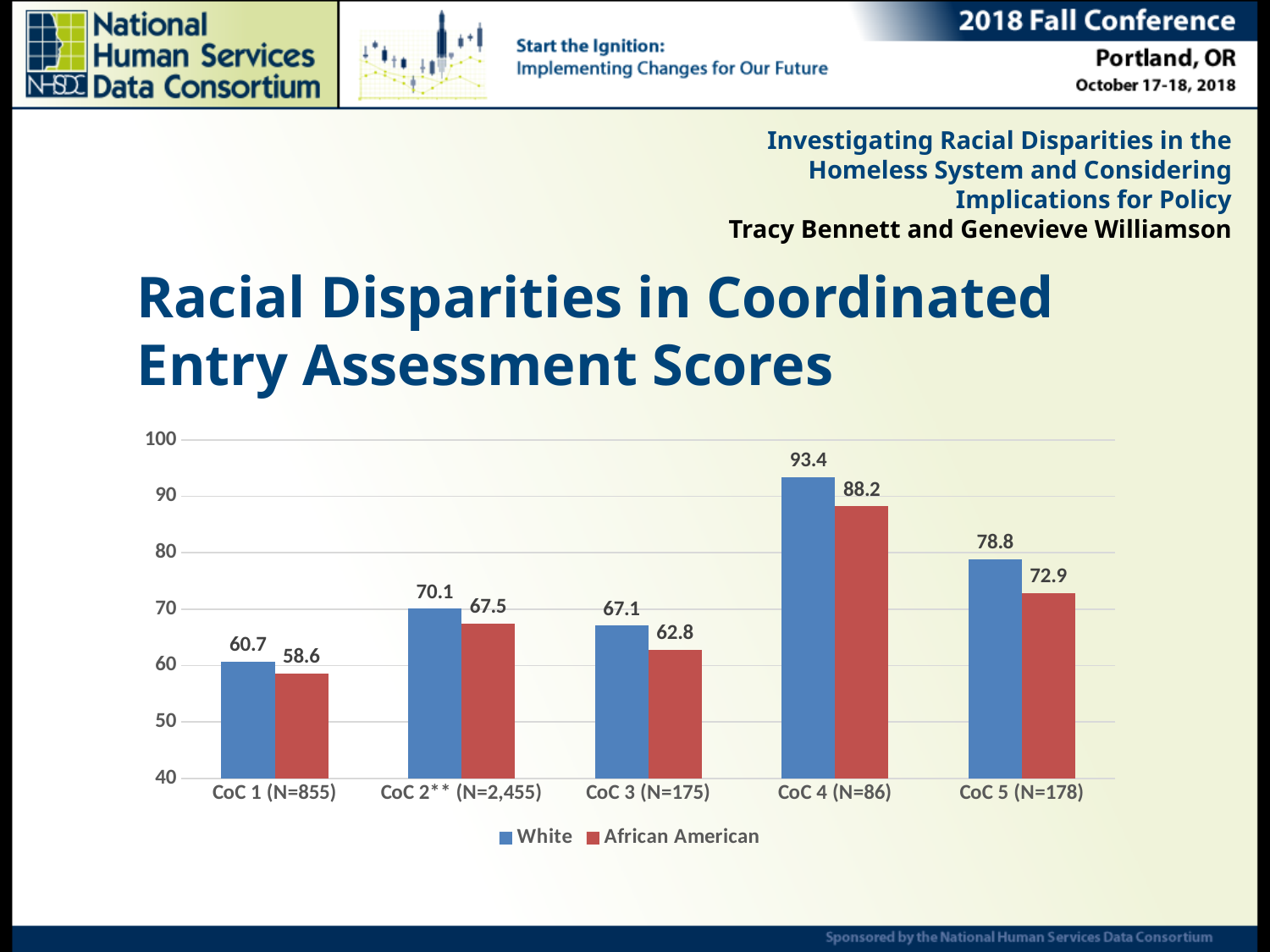
What is the value for African American in CoC 2** (N=2,455)? 67.5 What is the difference between the White and African American values in CoC 4 (N=86)? 5.2 What is the difference between the White and African American values in CoC 5 (N=178)? 5.9 What kind of chart is shown on the slide? Bar chart What is the value for African American in CoC 1 (N=855)? 58.6 Is the value for African American in CoC 5 (N=178) greater or less than 70? greater What is the value for White in CoC 4 (N=86)? 93.4 Which is larger in CoC 3 (N=175): the White value or the African American value? White Which category has the lowest value for the African American series? CoC 1 (N=855) How many categories are shown on the x axis? 5 How many series does the legend list? 2 Which category has the highest value for the White series? CoC 4 (N=86)